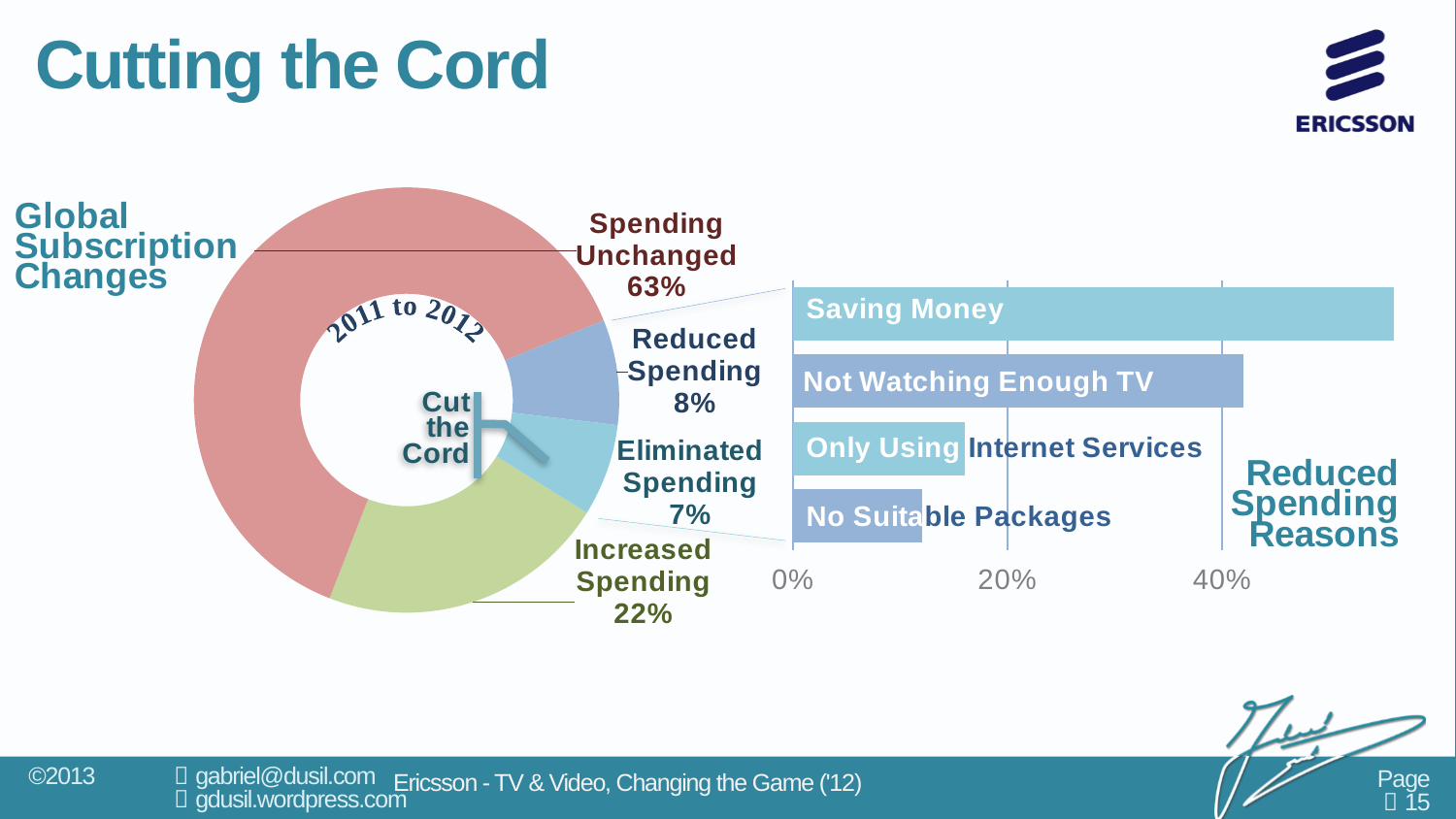
What kind of chart is the Reduced Spending Reasons chart? bar chart In the Global Subscription Changes donut chart, what is the difference between Spending Unchanged and Increased Spending? 41% In the Global Subscription Changes donut chart, which category has the smallest share? Eliminated Spending In the Global Subscription Changes donut chart, what share is Spending Unchanged? 63% In the Reduced Spending Reasons bar chart, is the value for Saving Money greater or less than 40%? greater In the Global Subscription Changes donut chart, which is larger: Reduced Spending or Eliminated Spending? Reduced Spending In the Reduced Spending Reasons bar chart, which reason has the longest bar? Saving Money In the Global Subscription Changes donut chart, which category has the largest share? Spending Unchanged How many categories are shown in the Global Subscription Changes donut chart? 4 In the Global Subscription Changes donut chart, what share is Eliminated Spending? 7% In the Reduced Spending Reasons bar chart, is the value for Only Using Internet Services greater or less than 20%? less In the Global Subscription Changes donut chart, what share is Increased Spending? 22%